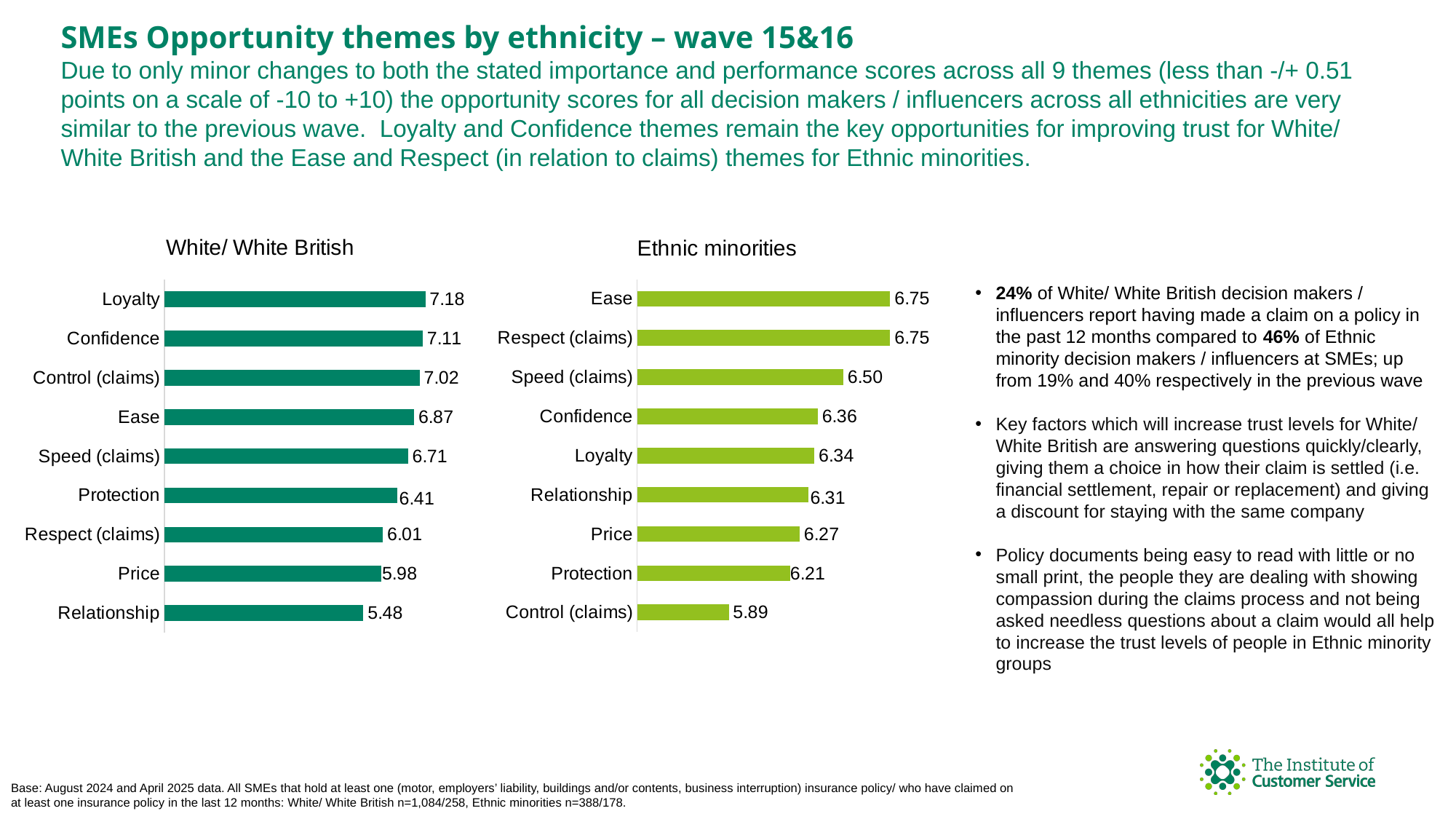
In the White/ White British chart, which theme has the highest value? Loyalty What is the title of the chart on the left? White/ White British In the White/ White British chart, what is the difference between Loyalty and Relationship? 1.70 What type of chart is the Ethnic minorities chart? Bar chart In the Ethnic minorities chart, which theme has the lowest value? Control (claims) Which is larger: Price in the White/ White British chart or Price in the Ethnic minorities chart? Price in the Ethnic minorities chart In the Ethnic minorities chart, what is the value for Protection? 6.21 In the Ethnic minorities chart, what is the difference between Ease and Control (claims)? 0.86 In the Ethnic minorities chart, what is the value for Speed (claims)? 6.50 In the White/ White British chart, which theme has the lowest value? Relationship In the White/ White British chart, what is the value for Loyalty? 7.18 In the White/ White British chart, how many themes are plotted? 9